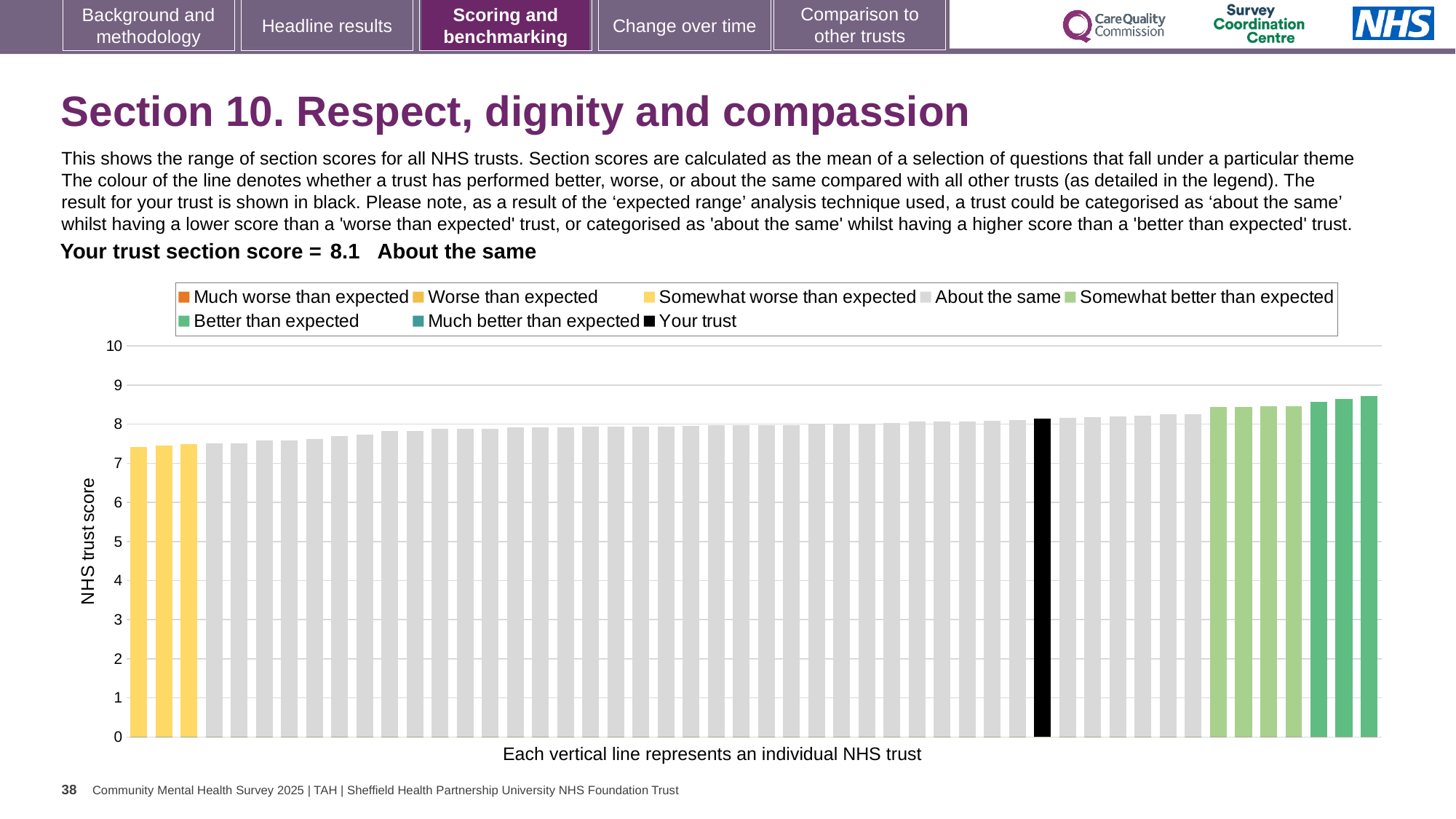
Is the value of the lowest bar greater or less than 7? greater What is the label on the vertical axis of the chart? NHS trust score What type of chart is shown on the slide? bar chart Is the value of the highest bar greater or less than 9? less Which category is your trust placed in for Section 10? About the same Do the bar values rise or fall from left to right along the x axis? rise Is the value of the rightmost bar greater or less than 8? greater What is the section score for your trust shown on the slide? 8.1 How many entries does the chart legend list? 8 What colour is the bar representing your trust? black